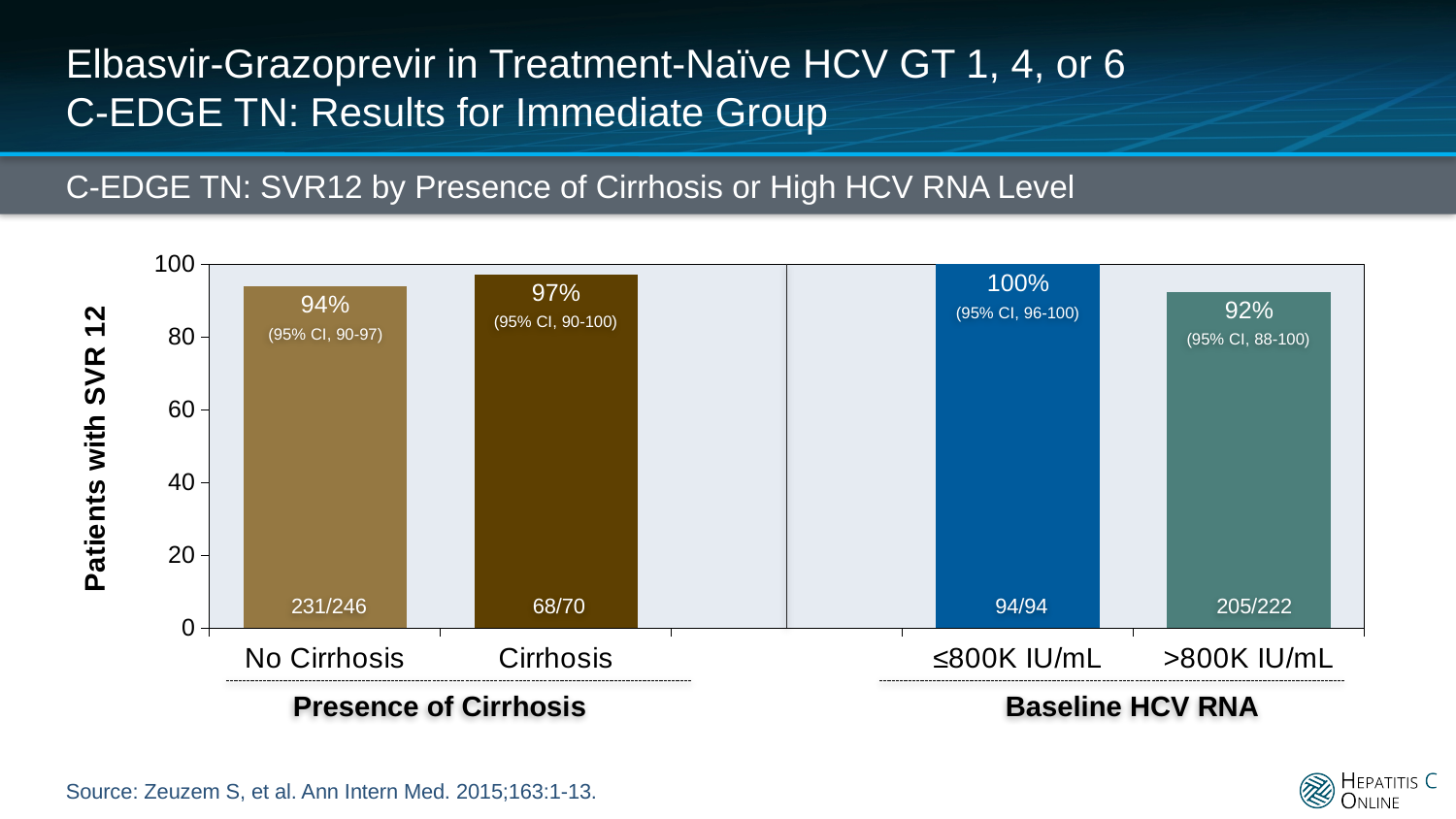
What is the SVR12 rate for patients with baseline HCV RNA ≤800K IU/mL? 100% Which category has the lowest SVR12 rate? >800K IU/mL What is the SVR12 rate for the No Cirrhosis group? 94% Which category has the highest SVR12 rate? ≤800K IU/mL What is the SVR12 rate for the Cirrhosis group? 97% How many patients achieved SVR12 out of the total in the No Cirrhosis group, as shown on the bar? 231/246 What type of chart is shown on the slide? Bar chart What is the difference in SVR12 rate between the ≤800K IU/mL and >800K IU/mL groups? 8% Which group has a higher SVR12 rate, No Cirrhosis or Cirrhosis? Cirrhosis How many bars are shown in the chart? 4 What is the 95% confidence interval shown for the Cirrhosis group? 90-100 What is the SVR12 rate for patients with baseline HCV RNA >800K IU/mL? 92%